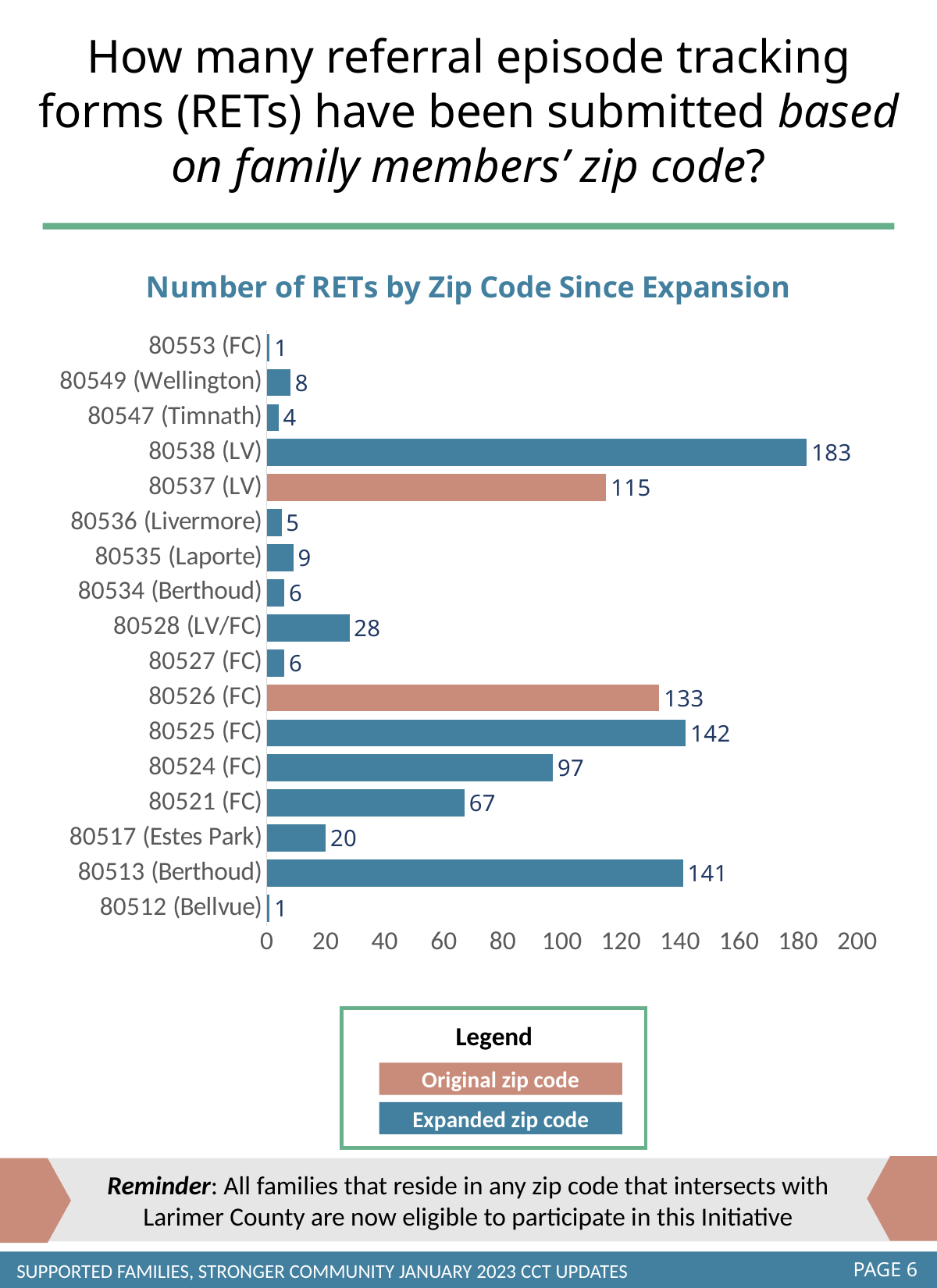
What is the title of the chart? Number of RETs by Zip Code Since Expansion What is the number of RETs for 80526 (FC)? 133 What kind of chart is shown on the slide? Bar chart How many zip codes are shown in the chart? 17 What is the number of RETs for 80538 (LV)? 183 Which zip code has the highest number of RETs? 80538 (LV) Which has more RETs, 80521 (FC) or 80528 (LV/FC)? 80521 (FC) What is the difference in RETs between 80525 (FC) and 80524 (FC)? 45 What is the difference in RETs between 80538 (LV) and 80537 (LV)? 68 Is the value for 80513 (Berthoud) greater or less than 100? greater How many entries does the legend list? 2 What is the number of RETs for 80517 (Estes Park)? 20